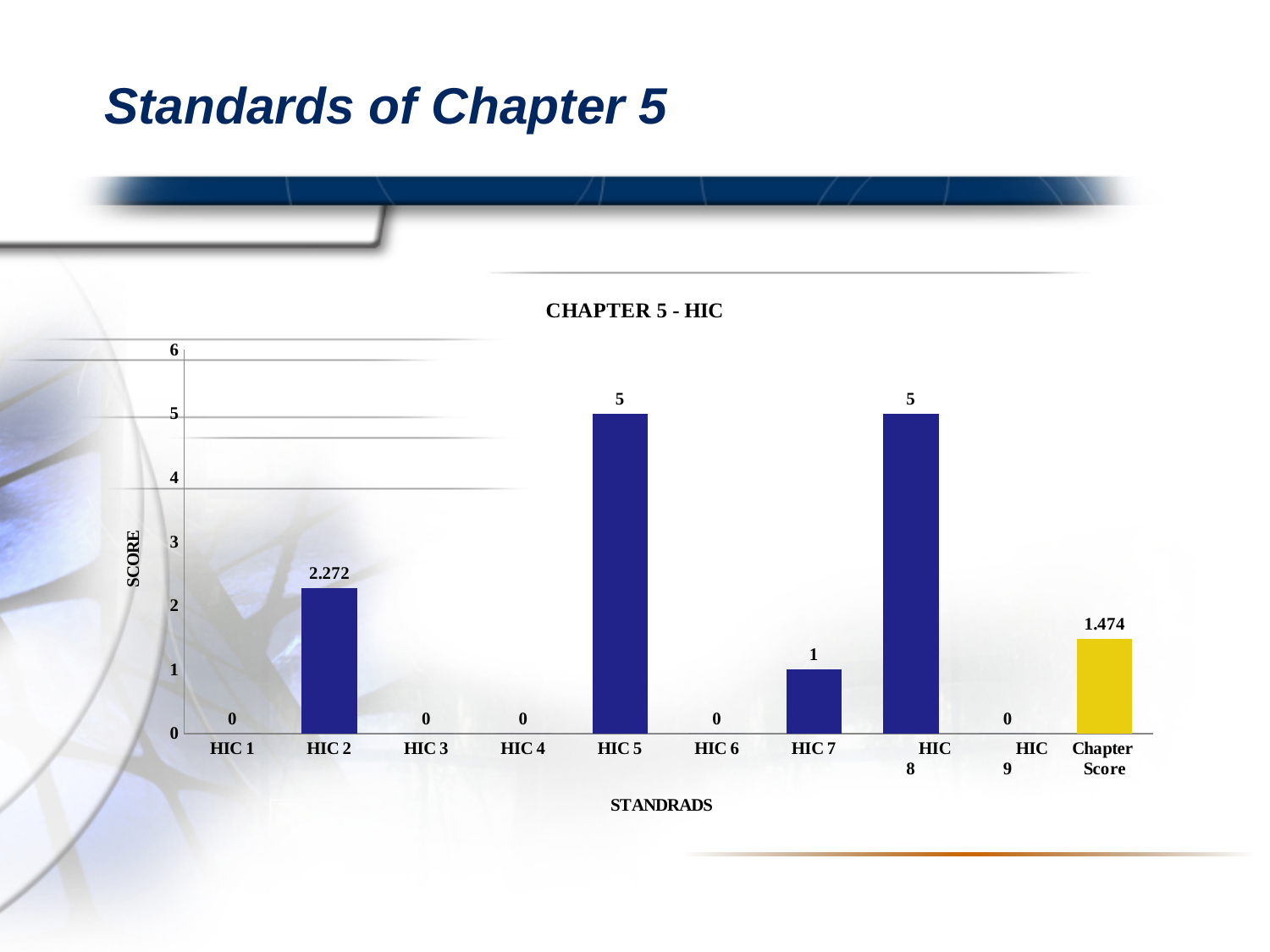
What is the difference between the score for HIC 5 and the score for HIC 7? 4 Which is larger, the score for HIC 2 or the Chapter Score? HIC 2 How many categories are shown on the x axis of the chart? 10 What is the Chapter Score shown in the chart? 1.474 How many standards have a score of 0? 5 What is the score for HIC 2? 2.272 What is the score for HIC 5? 5 What kind of chart is shown on the slide? Bar chart What is the title of the chart? CHAPTER 5 - HIC Which standards have the highest score in the chart? HIC 5 and HIC 8 What is the score for HIC 7? 1 What is the label of the y axis? SCORE